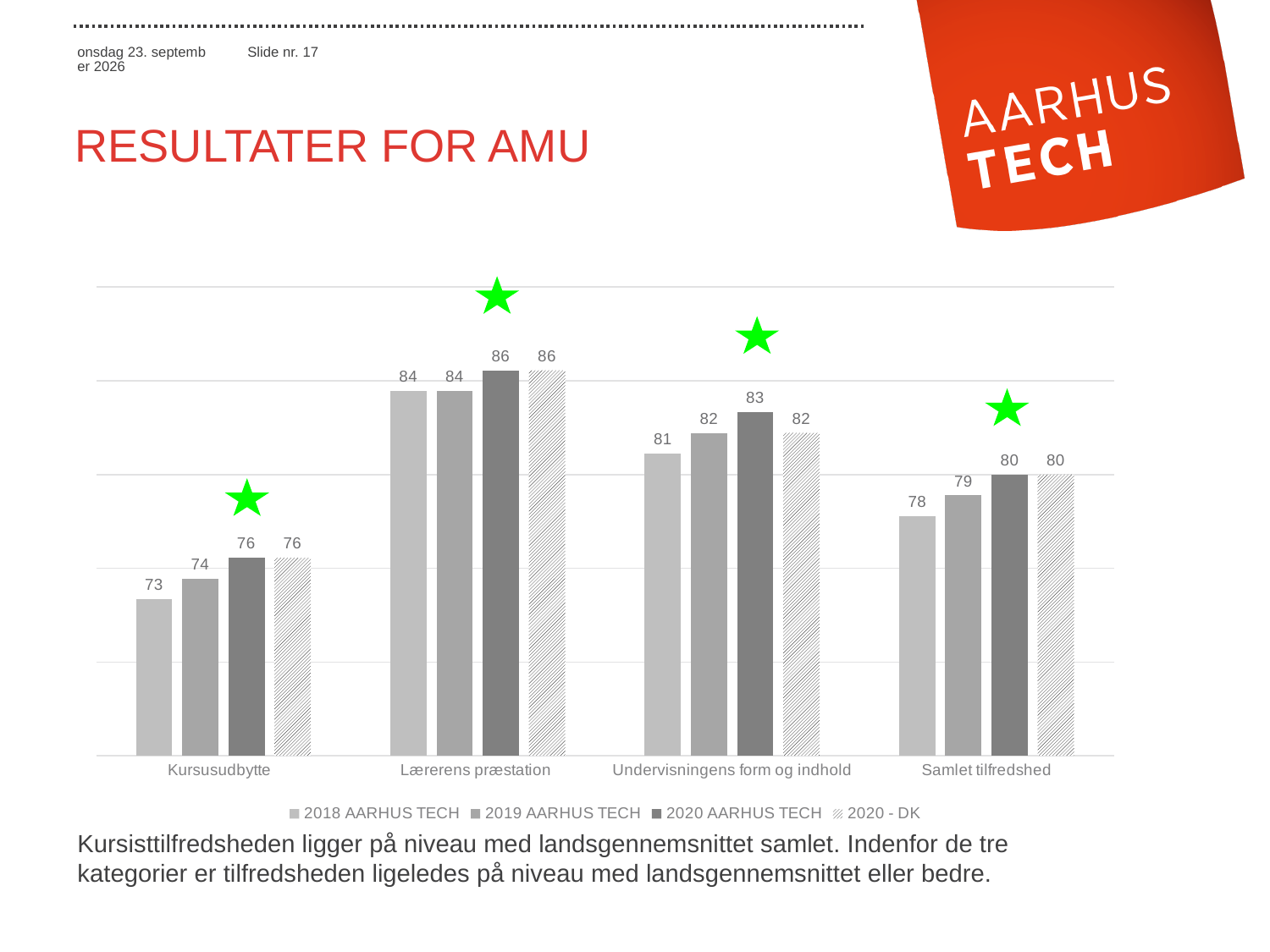
How many categories are shown on the x axis? 4 Do the AARHUS TECH values rise or fall from 2018 to 2020 in the Samlet tilfredshed category? Rise Which category has the lowest value for 2018 AARHUS TECH? Kursusudbytte What is the value for 2018 AARHUS TECH in the Lærerens præstation category? 84 What kind of chart is shown on the slide? Bar chart What is the value for 2019 AARHUS TECH in the Undervisningens form og indhold category? 82 What is the value for 2020 AARHUS TECH in the Kursusudbytte category? 76 What is the value for 2020 - DK in the Samlet tilfredshed category? 80 How many series does the legend list? 4 Which category has the highest value for 2020 AARHUS TECH? Lærerens præstation What is the difference between the 2020 AARHUS TECH and 2018 AARHUS TECH values in the Kursusudbytte category? 3 Which is larger in the Undervisningens form og indhold category: 2020 AARHUS TECH or 2020 - DK? 2020 AARHUS TECH